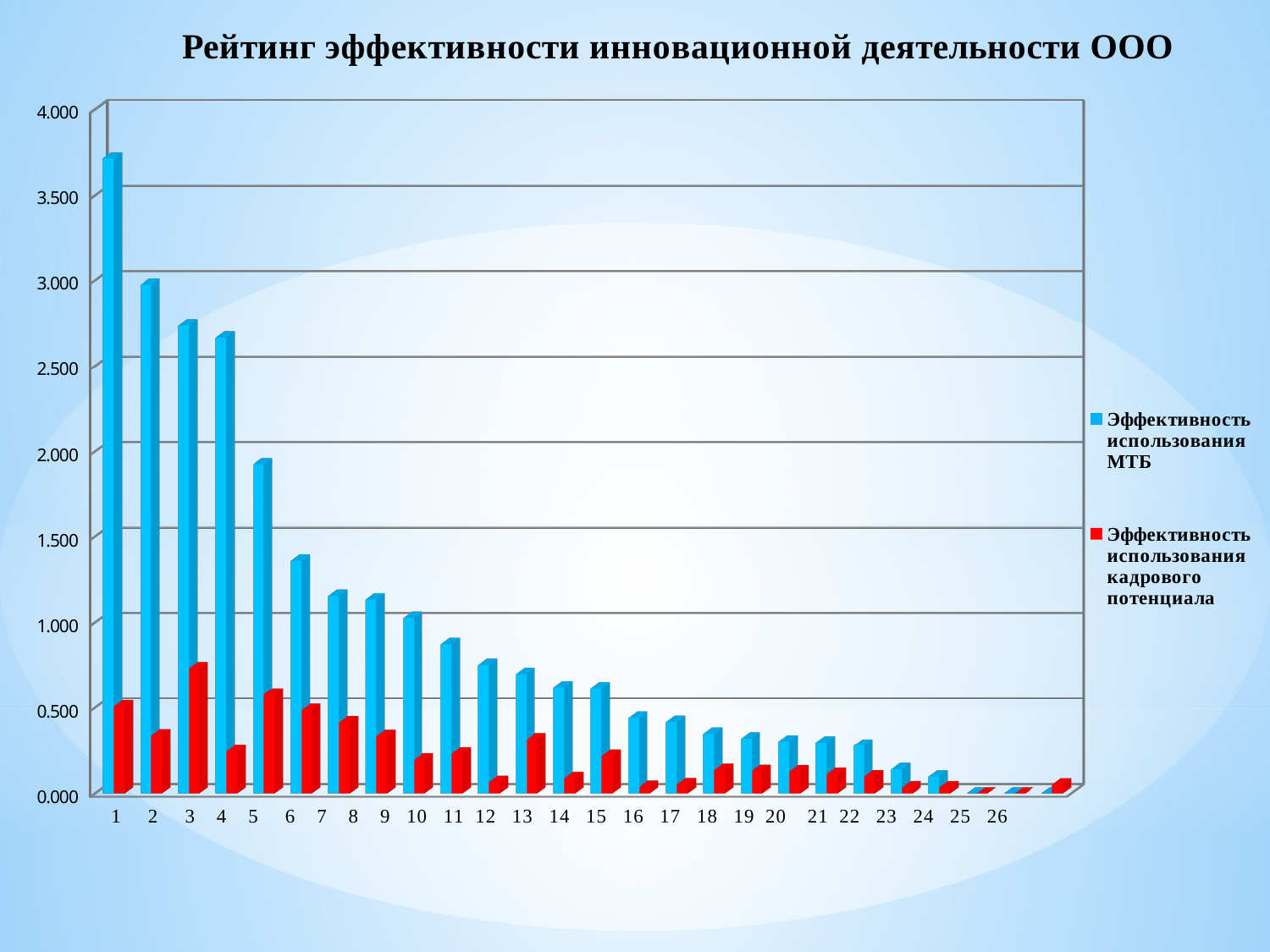
Do the values for 'Эффективность использования МТБ' rise or fall along the x axis? fall For 'Эффективность использования МТБ', which is larger: category 1 or category 2? category 1 Is the value for 'Эффективность использования кадрового потенциала' at category 3 greater or less than 0.500? greater How many series does the legend list? 2 Is the value for 'Эффективность использования МТБ' at category 5 greater or less than 1.500? greater What kind of chart is shown on the slide? bar chart At category 1, which series has the larger value: 'Эффективность использования МТБ' or 'Эффективность использования кадрового потенциала'? Эффективность использования МТБ Which colour represents the series 'Эффективность использования кадрового потенциала'? red Is the value for 'Эффективность использования МТБ' at category 1 greater or less than 3.500? greater Which category has the highest value for 'Эффективность использования кадрового потенциала'? 3 What is the title of the chart? Рейтинг эффективности инновационной деятельности ООО Which category has the highest value for 'Эффективность использования МТБ'? 1